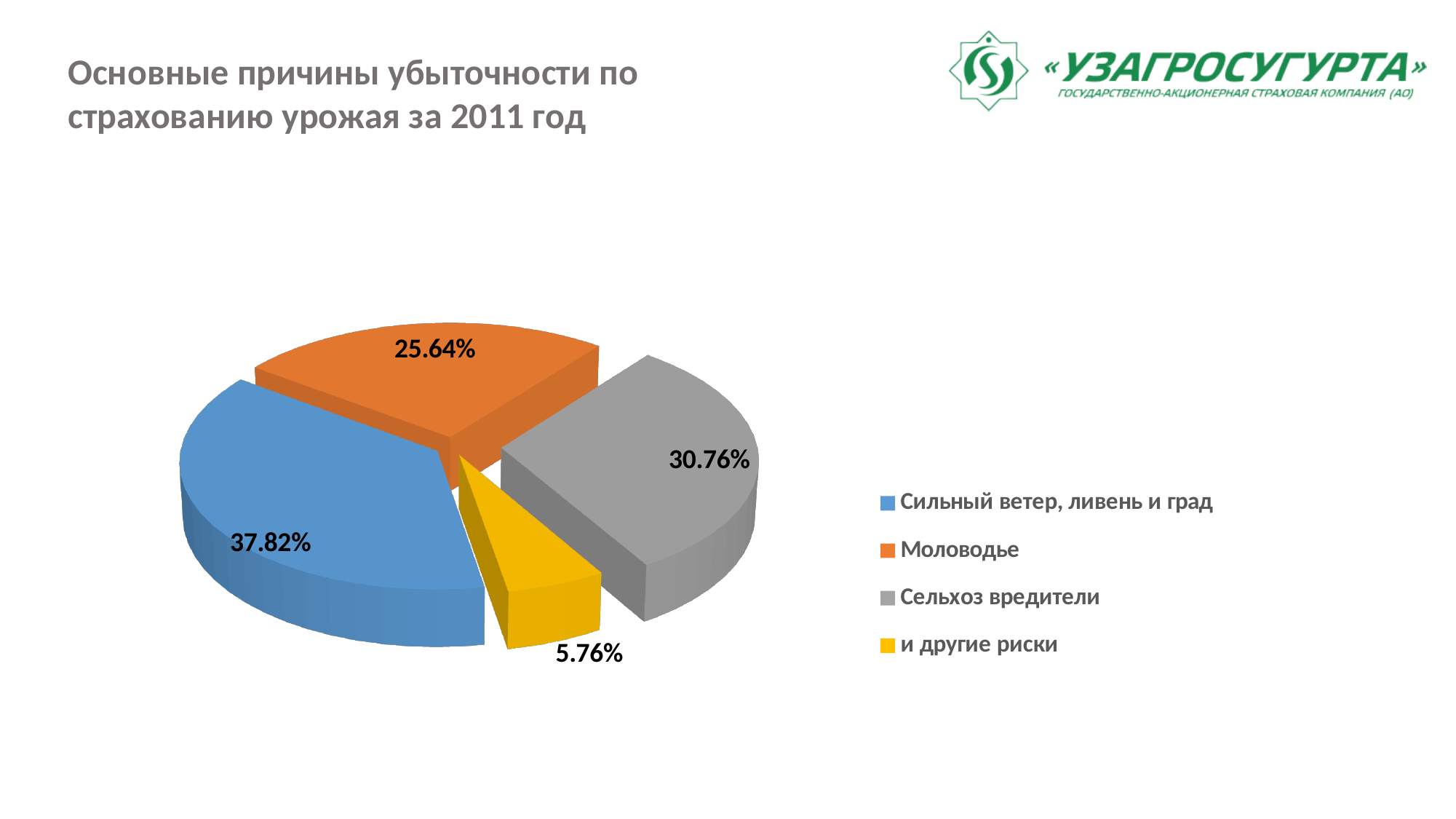
What colour is the slice for "Сельхоз вредители"? Grey Which category has the smallest slice of the pie? и другие риски What is the value shown for "Моловодье"? 25.64% What share of the pie does "Сильный ветер, ливень и град" account for? 37.82% What type of chart is shown on the slide? Pie chart What is the difference in percentage points between "Сильный ветер, ливень и град" and "Сельхоз вредители"? 7.06 Which is larger: the slice for "Моловодье" or the slice for "Сельхоз вредители"? Сельхоз вредители What is the value shown for "Сельхоз вредители"? 30.76% What is the title of the chart on the slide? Основные причины убыточности по страхованию урожая за 2011 год What is the value shown for "и другие риски"? 5.76% How many categories are shown in the pie chart? 4 Which category has the largest slice of the pie? Сильный ветер, ливень и град